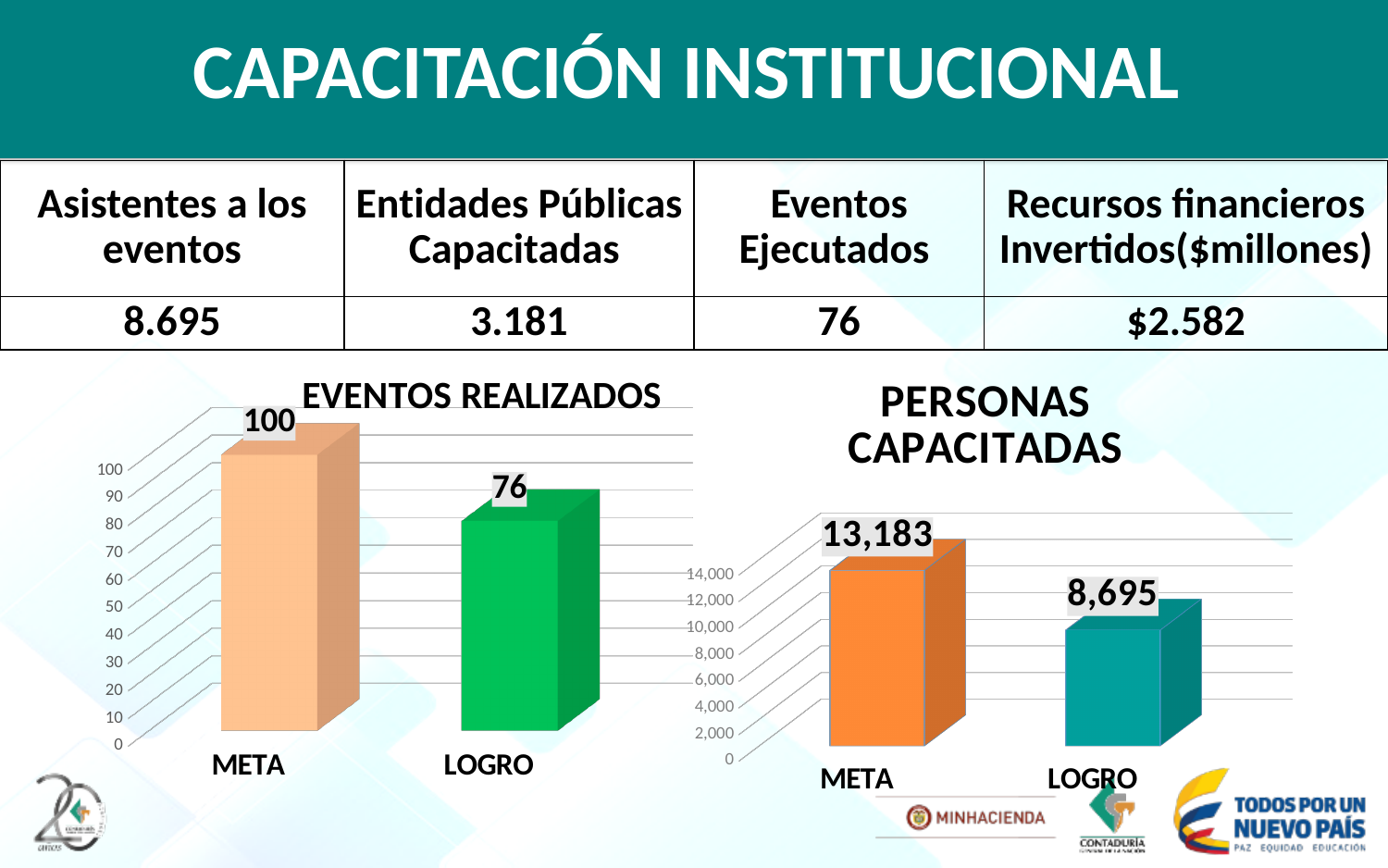
In the PERSONAS CAPACITADAS chart, what is the value for LOGRO? 8,695 In the EVENTOS REALIZADOS chart, what is the difference between META and LOGRO? 24 What type of chart is the PERSONAS CAPACITADAS chart? bar chart In the EVENTOS REALIZADOS chart, which category has the highest value? META In the PERSONAS CAPACITADAS chart, is the value for LOGRO greater or less than 10,000? less In the EVENTOS REALIZADOS chart, what is the value for META? 100 In the PERSONAS CAPACITADAS chart, is the value for META larger or smaller than the value for LOGRO? larger In the PERSONAS CAPACITADAS chart, what is the difference between META and LOGRO? 4,488 In the EVENTOS REALIZADOS chart, what is the value for LOGRO? 76 In the PERSONAS CAPACITADAS chart, what is the value for META? 13,183 In the PERSONAS CAPACITADAS chart, which category has the lowest value? LOGRO How many categories does the EVENTOS REALIZADOS chart show? 2